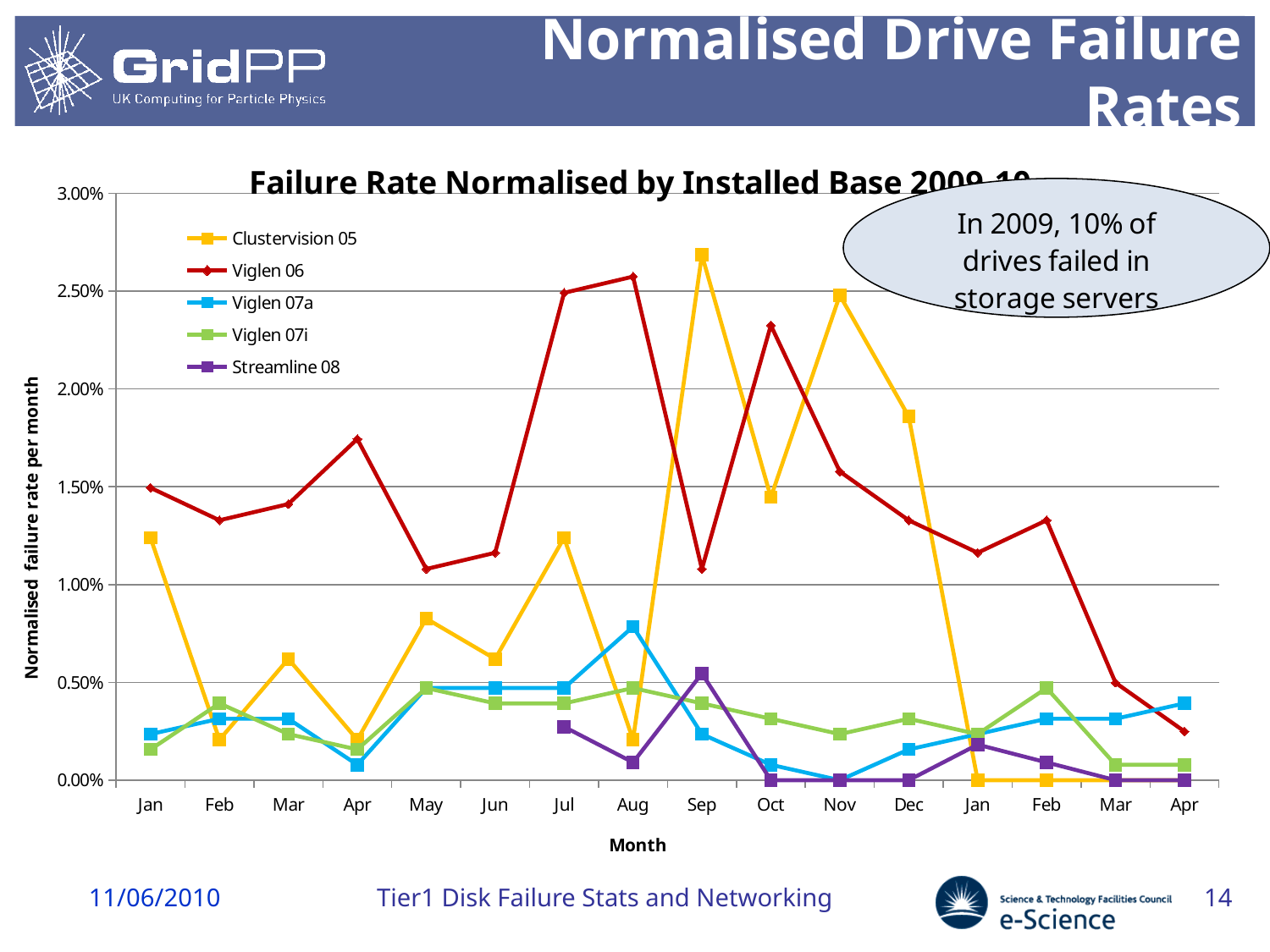
In which month does Clustervision 05 reach its highest value? Sep Is the value for Viglen 06 in May greater or less than 1.50%? less In Aug, which is higher: Viglen 07a or Clustervision 05? Viglen 07a Is the value for Clustervision 05 in Sep greater or less than 2.50%? greater What is the label of the y axis? Normalised failure rate per month Which series has the highest value in Sep? Clustervision 05 Does the Viglen 06 line rise or fall from the second Feb to the second Apr? fall How many series does the chart legend list? 5 What kind of chart is shown on the slide? line chart How many months are plotted along the x axis? 16 Which series has the highest value in the first Apr? Viglen 06 What is the title of the chart? Failure Rate Normalised by Installed Base 2009-10